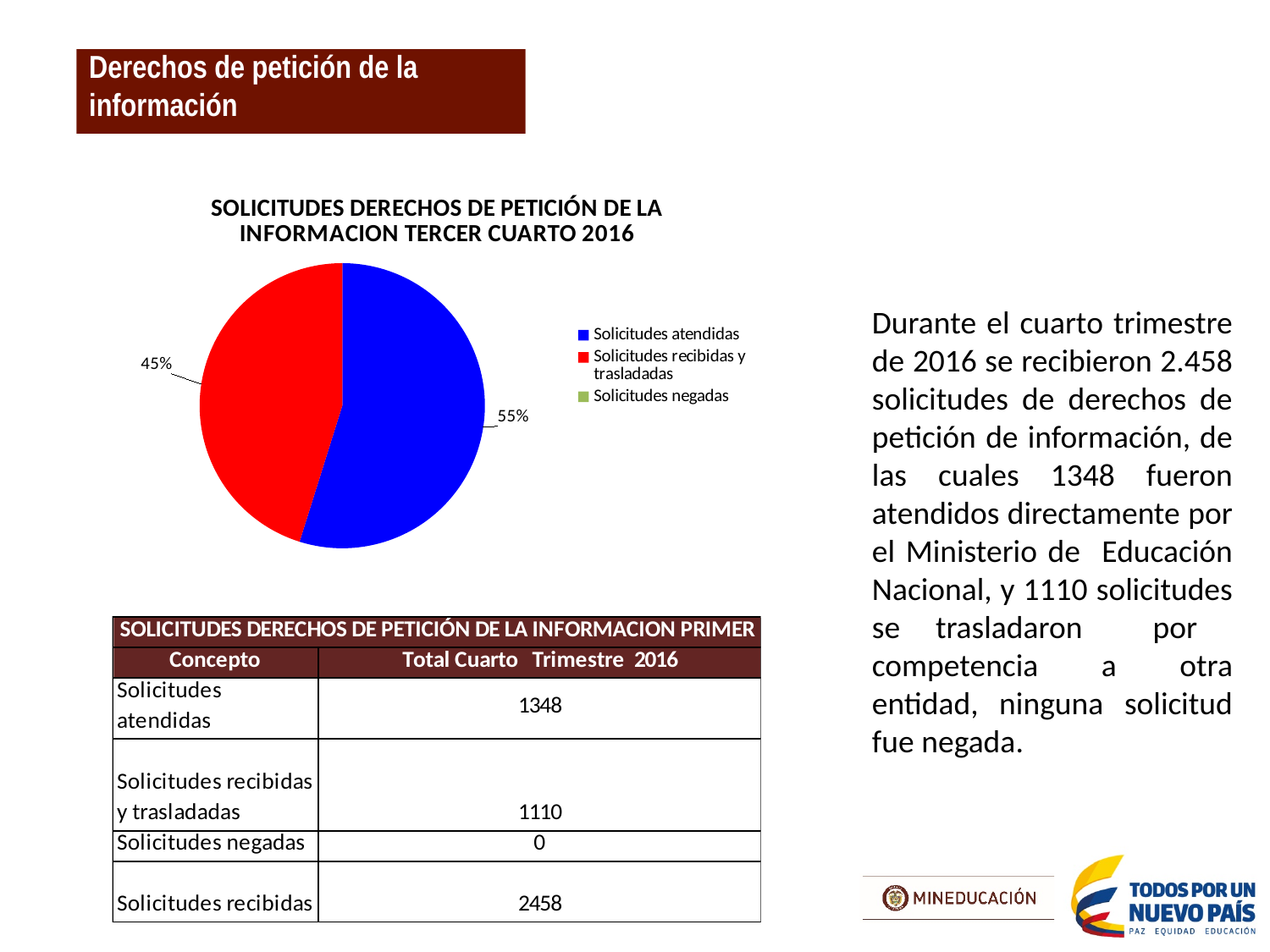
By how many percentage points does the "Solicitudes atendidas" slice exceed the "Solicitudes recibidas y trasladadas" slice? 10 percentage points What share of the pie does "Solicitudes atendidas" represent? 55% What colour is the slice for "Solicitudes recibidas y trasladadas"? red What share of the pie does "Solicitudes recibidas y trasladadas" represent? 45% How many slices with percentage labels are visible in the pie chart? 2 Is the share for "Solicitudes atendidas" greater or less than 50%? greater Which is larger: the slice for "Solicitudes atendidas" or the slice for "Solicitudes recibidas y trasladadas"? Solicitudes atendidas What kind of chart is shown on the slide? pie chart How many entries does the legend of the pie chart list? 3 What is the title of the pie chart? SOLICITUDES DERECHOS DE PETICIÓN DE LA INFORMACION TERCER CUARTO 2016 Which category has the largest slice of the pie? Solicitudes atendidas